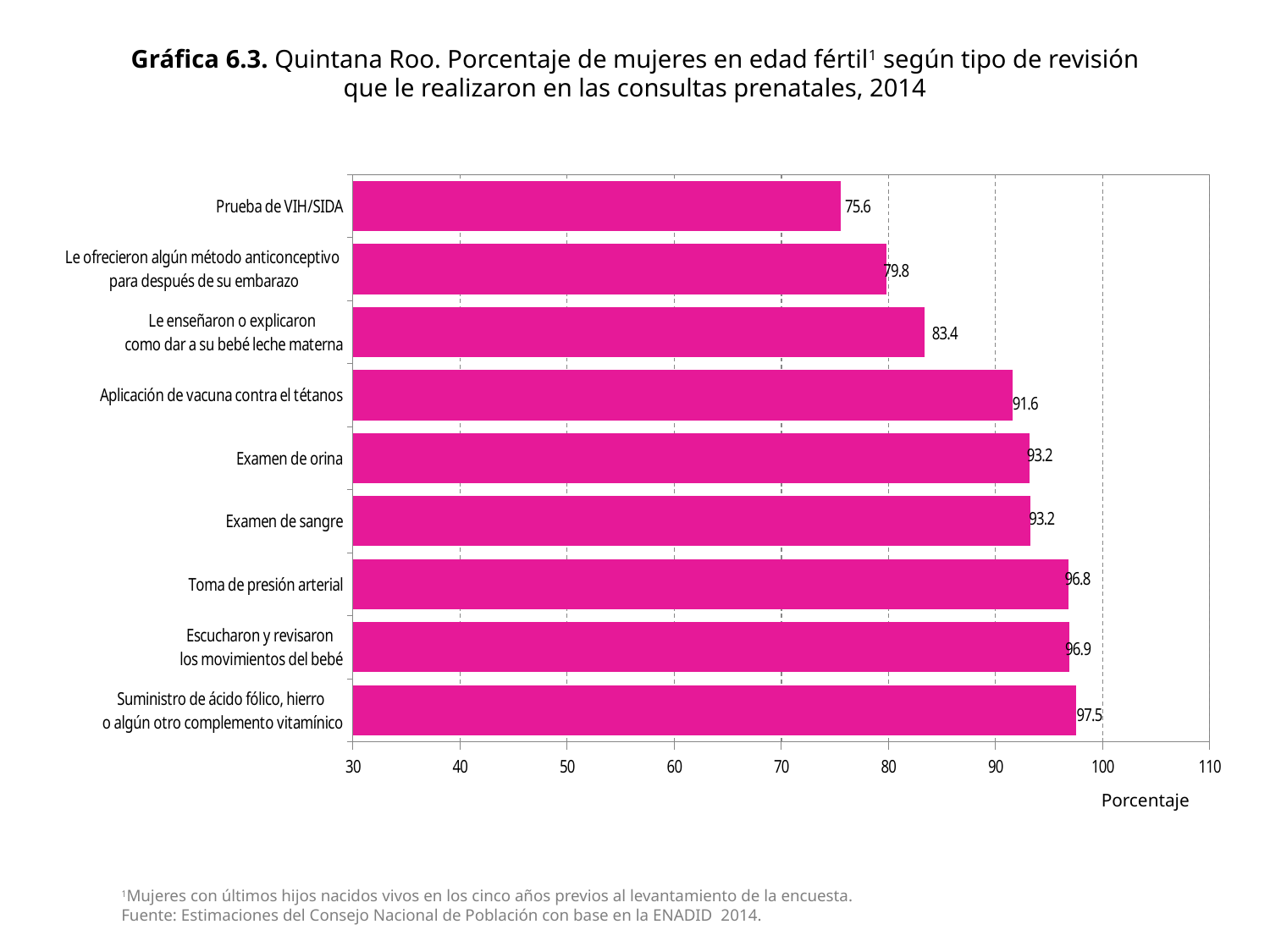
What year does the chart title refer to? 2014 What is the value for Aplicación de vacuna contra el tétanos? 91.6 Is the value for Examen de sangre greater or less than 90? greater What is the value for Prueba de VIH/SIDA? 75.6 What is the label of the horizontal axis? Porcentaje Which category has the highest value? Suministro de ácido fólico, hierro o algún otro complemento vitamínico Which is larger: the value for Le enseñaron o explicaron como dar a su bebé leche materna or the value for Le ofrecieron algún método anticonceptivo para después de su embarazo? Le enseñaron o explicaron como dar a su bebé leche materna What is the value for Toma de presión arterial? 96.8 Which category has the lowest value? Prueba de VIH/SIDA How many categories are shown in the chart? 9 What kind of chart is shown on the slide? Bar chart What is the difference between the values for Examen de orina and Prueba de VIH/SIDA? 17.6